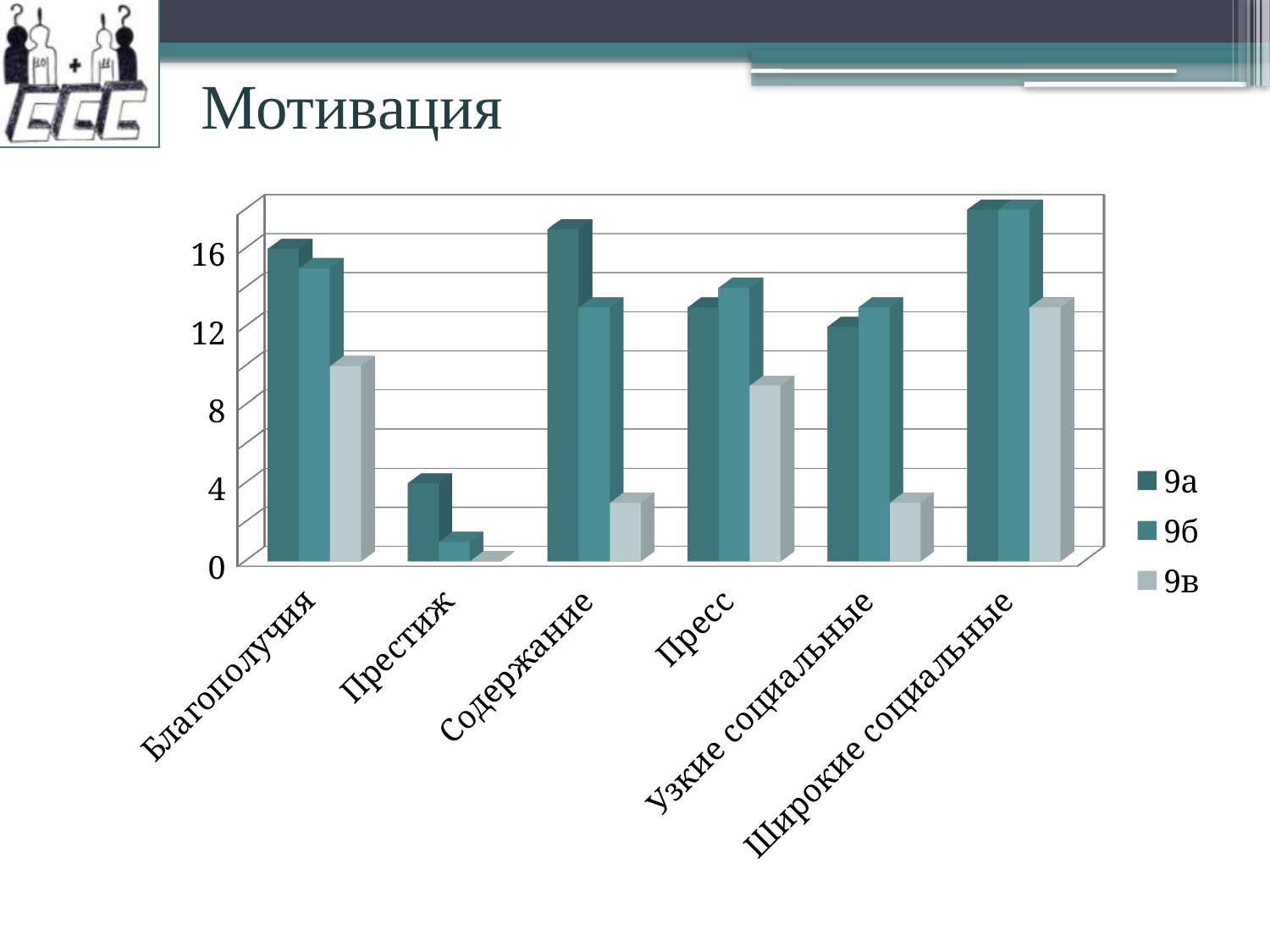
Is the value for 9в in Благополучия greater or less than 8? greater What is the title of the slide with the chart? Мотивация Is the value for 9а in Престиж greater or less than 8? less Is the value for 9а in Содержание greater or less than 12? greater How many series does the legend list? 3 How many categories are shown on the x axis? 6 What kind of chart is shown on the slide? bar chart For series 9а, which category has the larger value, Благополучия or Престиж? Благополучия Which category has the highest value for series 9в? Широкие социальные Which category has the lowest value for series 9а? Престиж In Содержание, which series has the larger value, 9а or 9в? 9а